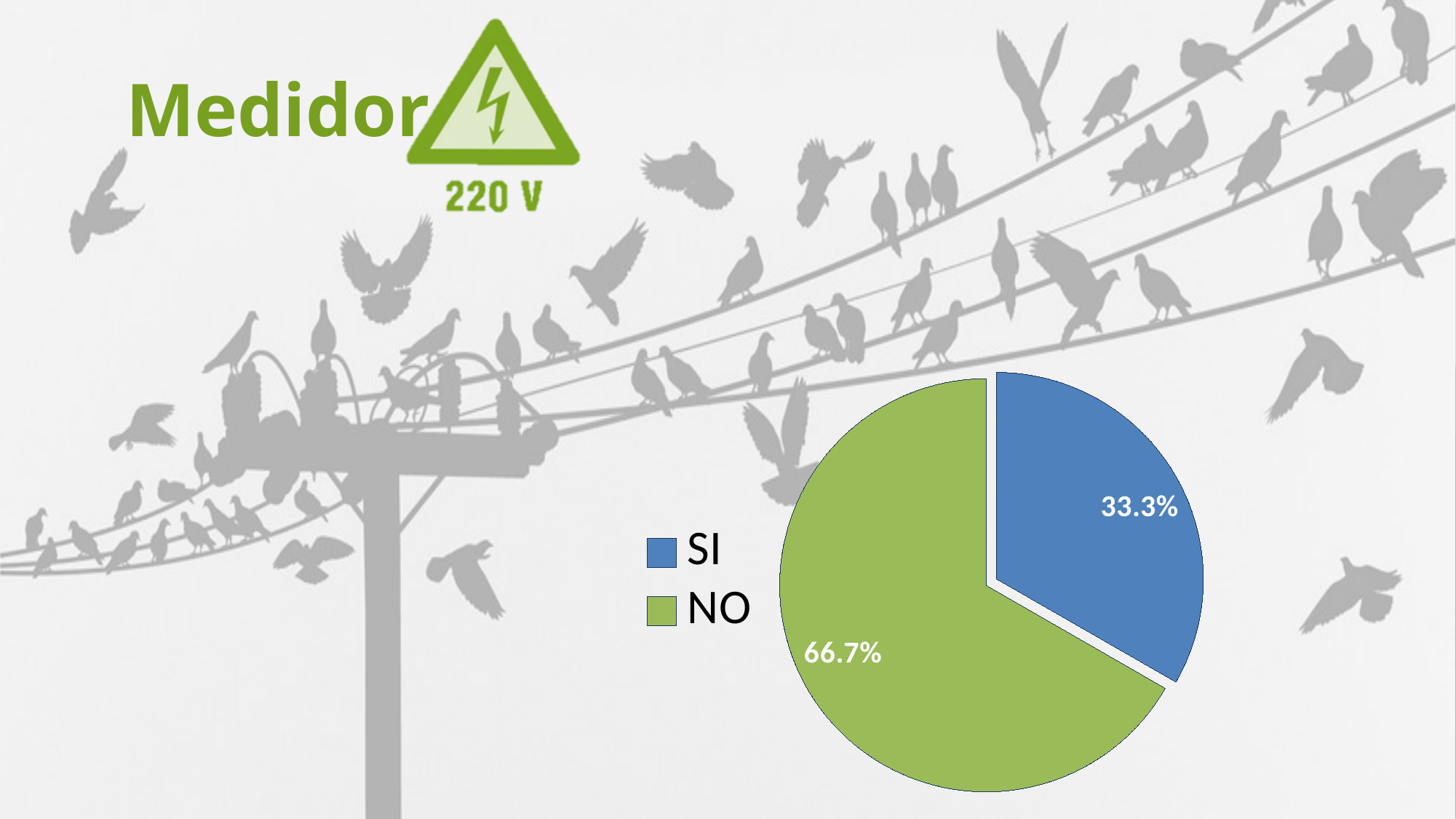
How many slices does the pie chart have? 2 What share of the pie chart does the SI slice represent? 33.3% What kind of chart is shown on the slide? Pie chart What is the title text shown on the slide? Medidor What is the difference in percentage points between the NO and SI slices? 33.4 What share of the pie chart does the NO slice represent? 66.7% How many entries does the legend list? 2 Which slice of the pie chart is the smallest? SI Which is larger, the SI slice or the NO slice? NO Which slice of the pie chart is the largest? NO What colour is the SI slice in the pie chart? Blue